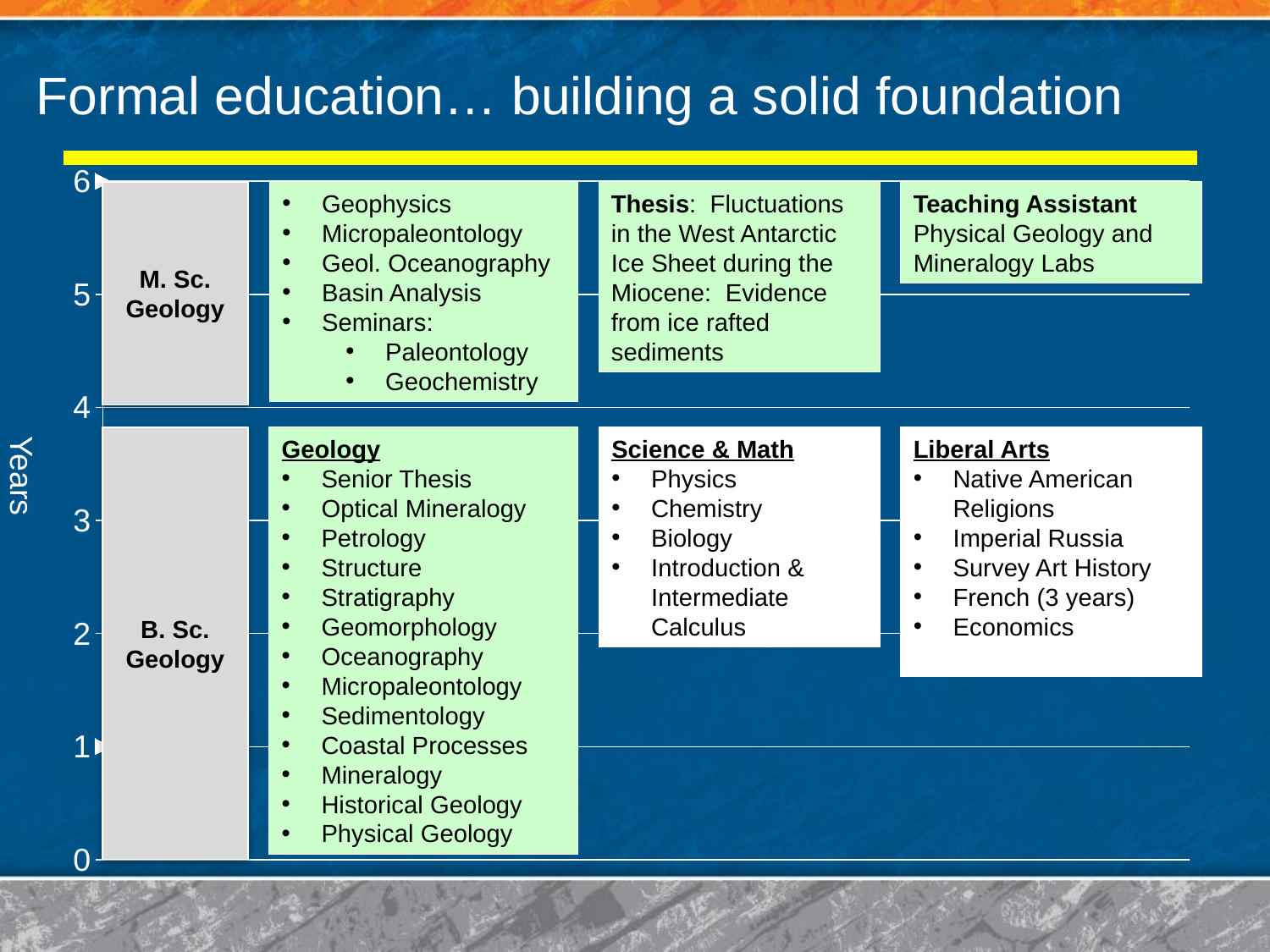
What label is shown on the vertical axis of the chart? Years What is the total number of years covered by the stacked bar? 6 At what year value does the M. Sc. Geology segment end? 6 What kind of chart is used to show the years of formal education? bar chart Which degree segment spans more years, B. Sc. Geology or M. Sc. Geology? B. Sc. Geology At what year value does the B. Sc. Geology segment end? 4 What is the highest value shown on the vertical axis? 6 How many years does the M. Sc. Geology segment span? 2 How many years does the B. Sc. Geology segment span? 4 What is the difference in years between the B. Sc. Geology segment and the M. Sc. Geology segment? 2 Is the number of years for the B. Sc. Geology segment greater or less than 3? greater How many degree segments are shown in the stacked bar? 2